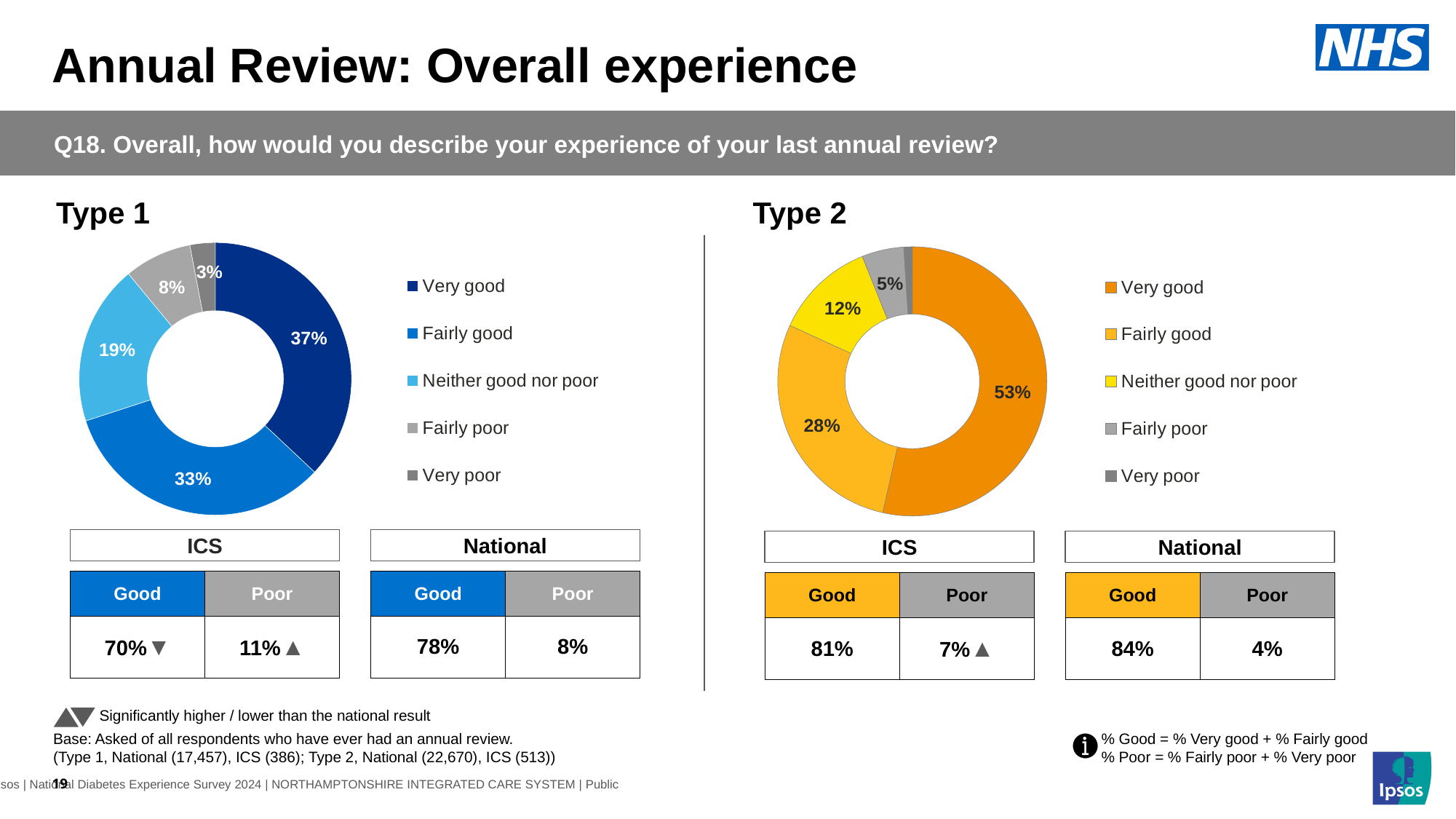
In the Type 2 chart, what is the difference in percentage points between 'Very good' and 'Fairly good'? 25 In the Type 2 chart, what percentage of respondents said their experience was 'Very good'? 53% How many response categories does the legend of the Type 2 chart list? 5 In the Type 2 chart, what percentage of respondents said 'Fairly good'? 28% In the Type 2 chart, which response category has the largest share? Very good In the Type 1 chart, what percentage of respondents said 'Neither good nor poor'? 19% In the Type 1 chart, what percentage of respondents said their experience was 'Very good'? 37% In the Type 1 chart, what is the difference in percentage points between 'Very good' and 'Fairly good'? 4 Which chart has a larger 'Neither good nor poor' share, Type 1 or Type 2? Type 1 What kind of chart is used to show the Type 1 results? Donut (pie) chart In the Type 1 chart, which response category has the largest share? Very good In the Type 1 chart, which response category has the smallest share? Very poor